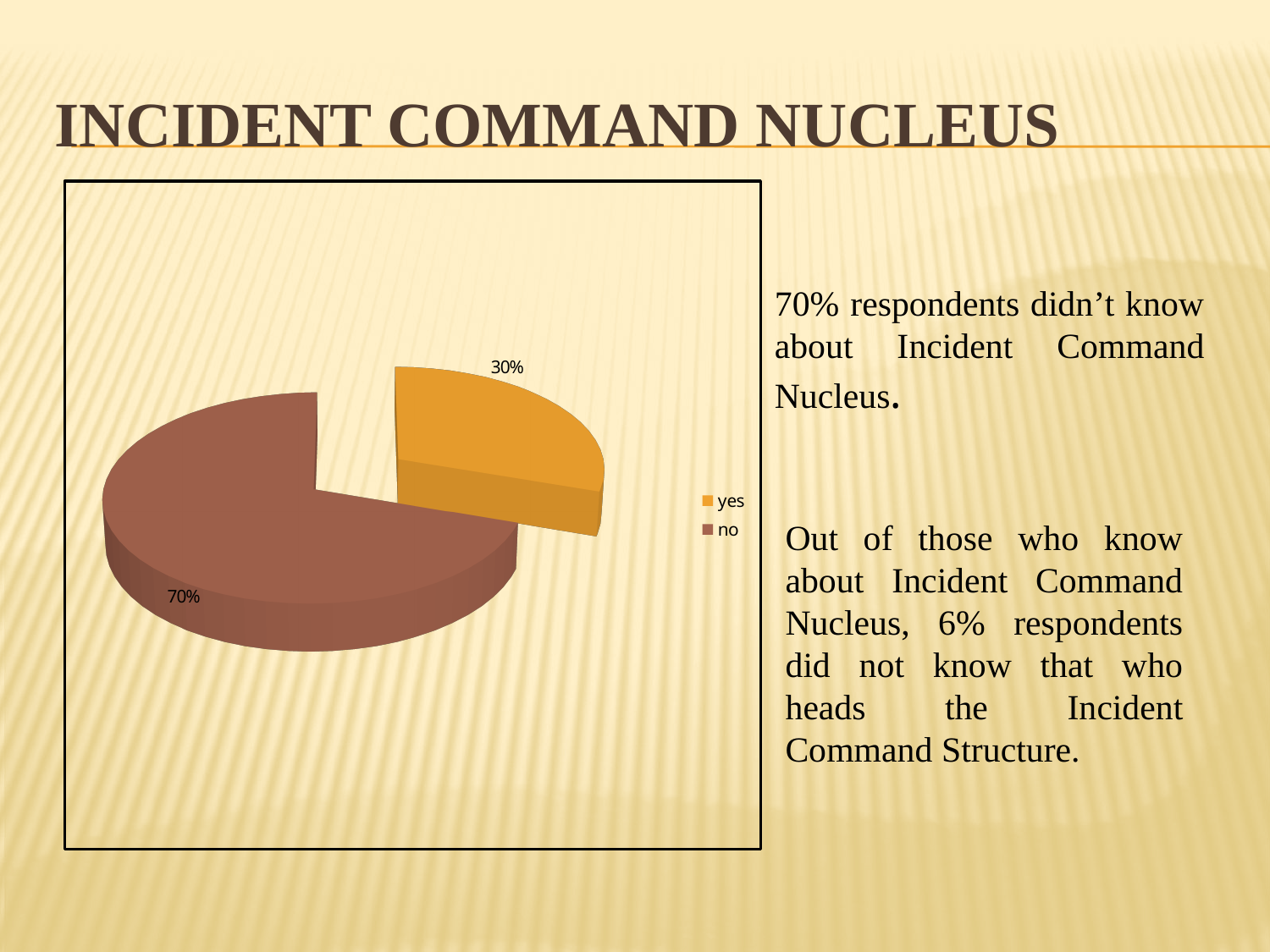
How many entries does the legend list? 2 What is the share of the pie taken by the "no" slice? 70% What colour is the "no" slice in the pie chart? brown What is the difference in percentage points between the "no" slice and the "yes" slice? 40% What percentage of the pie does the "no" slice represent? 70% Which slice of the pie is the largest? no How many slices does the pie chart have? 2 What colour is the "yes" slice in the pie chart? orange What kind of chart is shown on the slide? pie chart What percentage of the pie does the "yes" slice represent? 30% Which is larger, the "yes" slice or the "no" slice? no Which slice of the pie is the smallest? yes